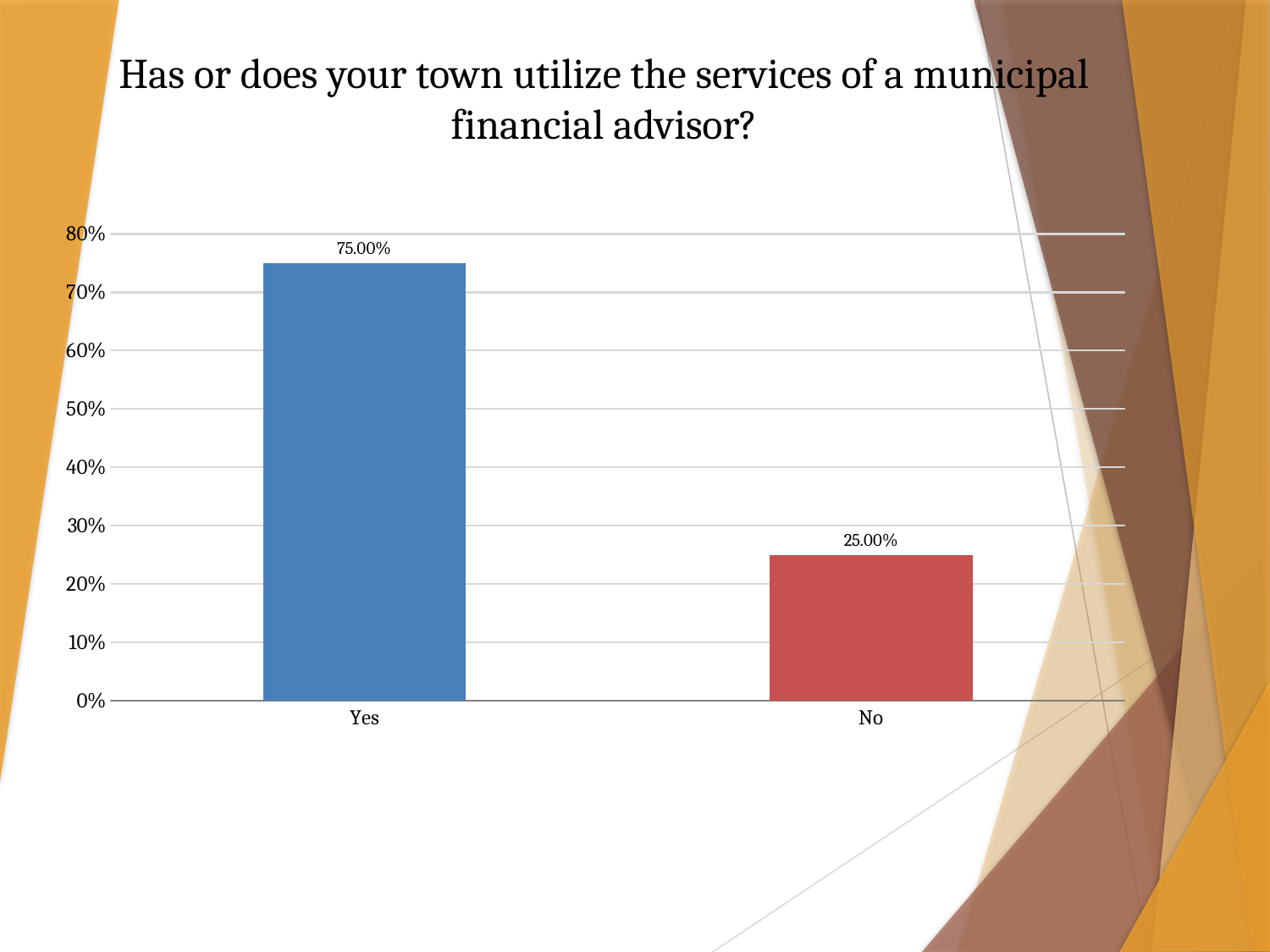
Is the value for Yes greater or less than 70%? greater Which category has the highest value? Yes Which category has the lowest value? No What is the title of the chart? Has or does your town utilize the services of a municipal financial advisor? What is the difference between the values for Yes and No? 50.00% What kind of chart is shown on the slide? bar chart Is the value for No greater or less than 30%? less What is the value for No? 25.00% Which is larger, the value for Yes or the value for No? Yes What is the value for Yes? 75.00% How many categories are shown on the x axis? 2 What colour is the bar for No? red